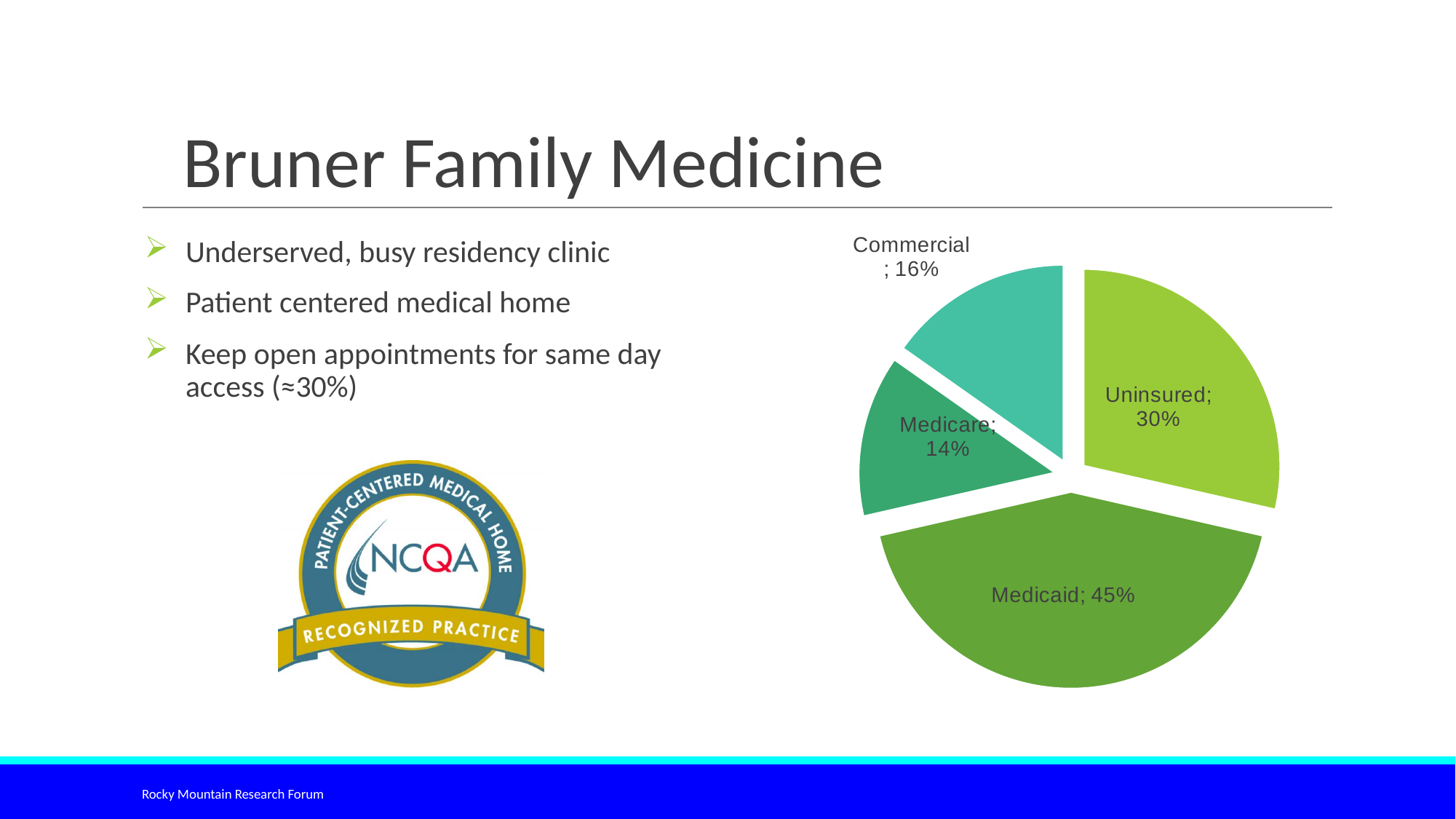
Which is larger, Commercial or Medicare? Commercial What is the difference between the Medicaid and Uninsured percentages? 15% Which category has the smallest slice of the pie? Medicare What is the difference between the Commercial and Medicare percentages? 2% What share of the pie does Medicaid represent? 45% How many slices does the pie chart have? 4 What kind of chart is shown on the slide? pie chart What is the value shown for Commercial? 16% What is the combined share of Uninsured and Medicaid? 75% What is the value shown for Uninsured? 30% Which category has the largest slice of the pie? Medicaid What is the value shown for Medicare? 14%